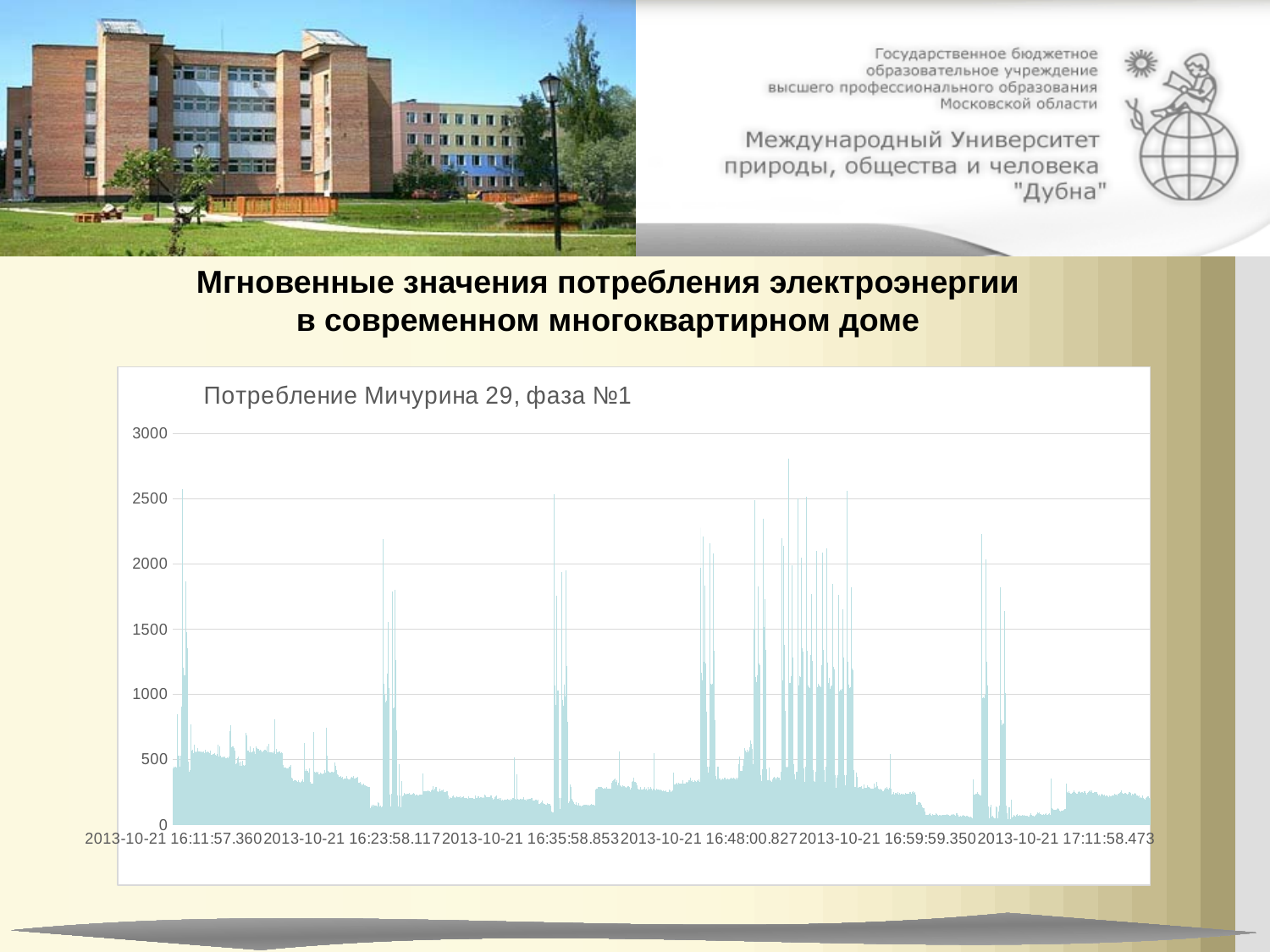
What is the interval between consecutive tick labels on the vertical axis? 500 Is the highest spike in the chart greater or less than 3000? less What kind of chart is shown on the slide? area chart How many timestamp labels are shown along the horizontal axis? 6 What is the first timestamp label on the horizontal axis? 2013-10-21 16:11:57.360 What is the highest value labelled on the vertical axis of the chart? 3000 What is the last timestamp label on the horizontal axis? 2013-10-21 17:11:58.473 What is the title of the chart? Потребление Мичурина 29, фаза №1 Is the highest spike in the chart greater or less than 2500? greater Is the baseline consumption level around 2013-10-21 16:35:58.853 greater or less than 500? less